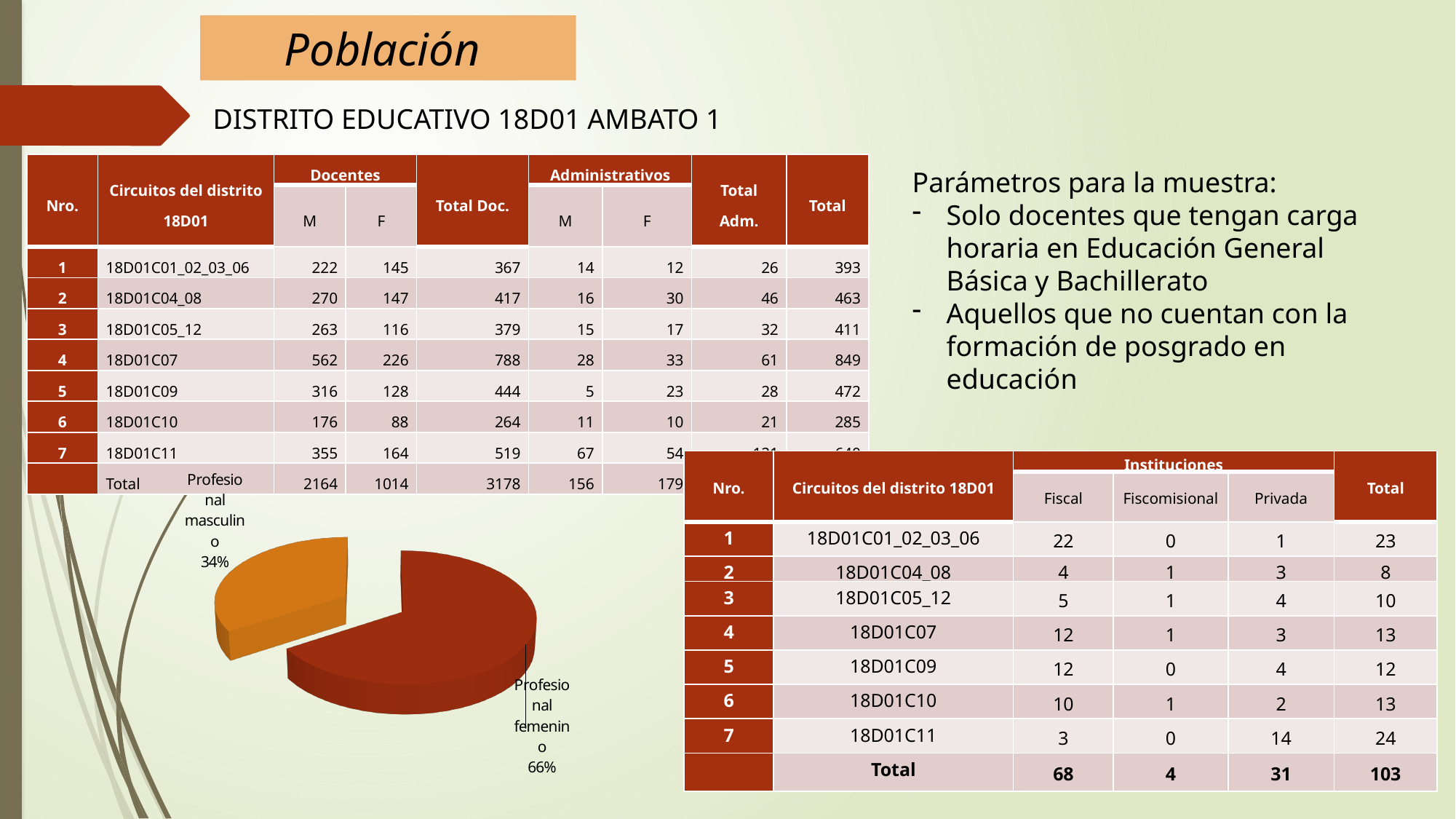
In the pie chart, what share is labelled for Profesional masculino? 34% What colour is the Profesional femenino slice in the pie chart? dark red In the pie chart, what is the difference in percentage points between Profesional femenino and Profesional masculino? 32 What kind of chart is shown at the bottom left of the slide? pie chart What colour is the Profesional masculino slice in the pie chart? orange In the pie chart, which is larger: Profesional masculino or Profesional femenino? Profesional femenino Is the share for Profesional masculino in the pie chart greater or less than 50%? less Which slice of the pie chart is the smallest? Profesional masculino How many slices does the pie chart have? 2 Which slice of the pie chart is the largest? Profesional femenino In the pie chart, what share is labelled for Profesional femenino? 66%